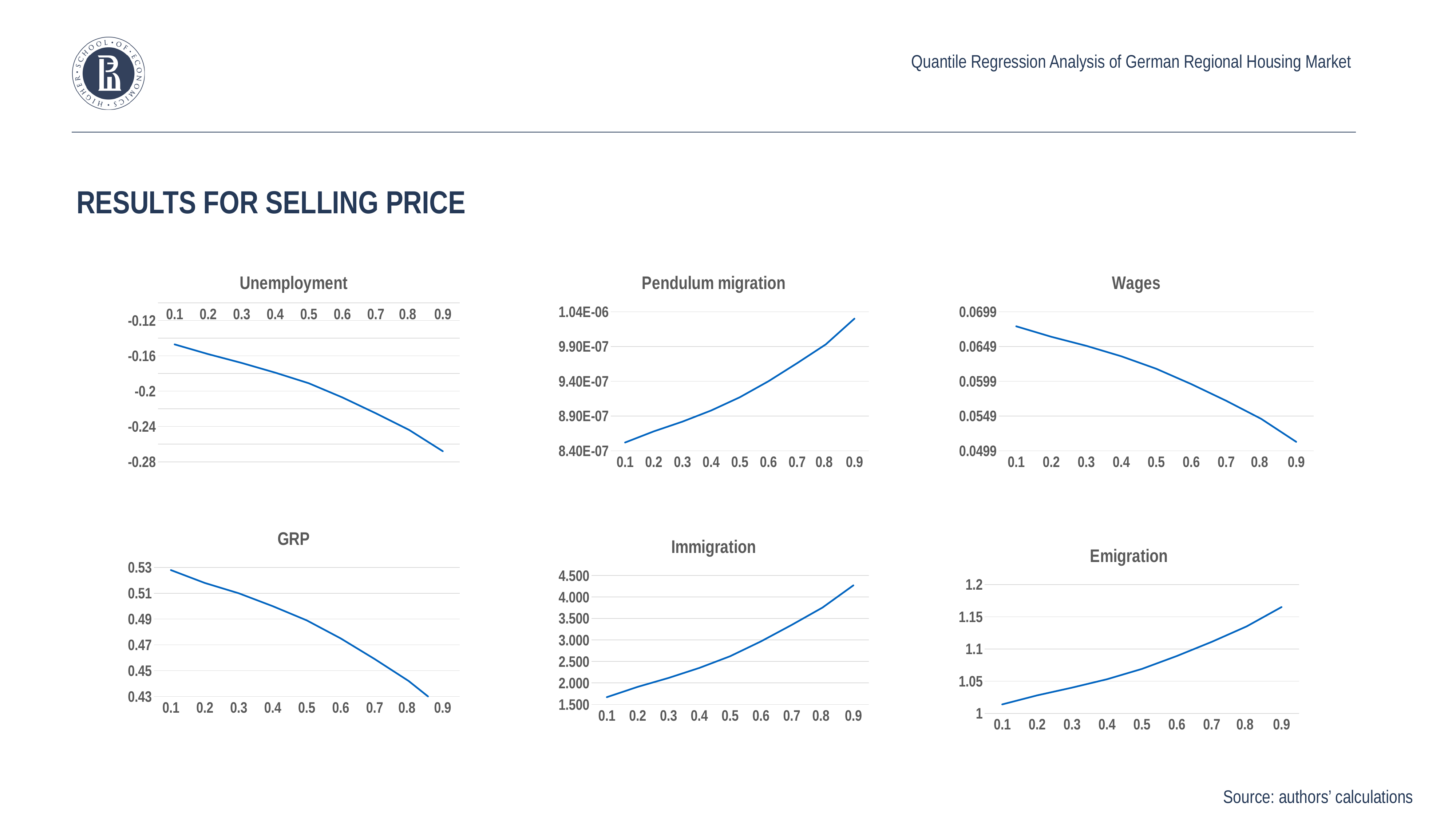
In the Unemployment chart, do the values rise or fall as the quantile increases from 0.1 to 0.9? fall In the Wages chart, is the value at 0.1 greater or less than 0.0649? greater In the Wages chart, at which quantile is the value lowest? 0.9 In the Pendulum migration chart, is the value at 0.9 greater or less than 9.90E-07? greater How many charts are shown on the slide? 6 In the Emigration chart, is the value at 0.1 greater or less than 1.05? less In the Pendulum migration chart, do the values rise or fall along the x axis? rise What kind of chart is the Unemployment chart? line chart In the Immigration chart, which is larger, the value at 0.1 or the value at 0.9? 0.9 In the GRP chart, at which quantile is the value highest? 0.1